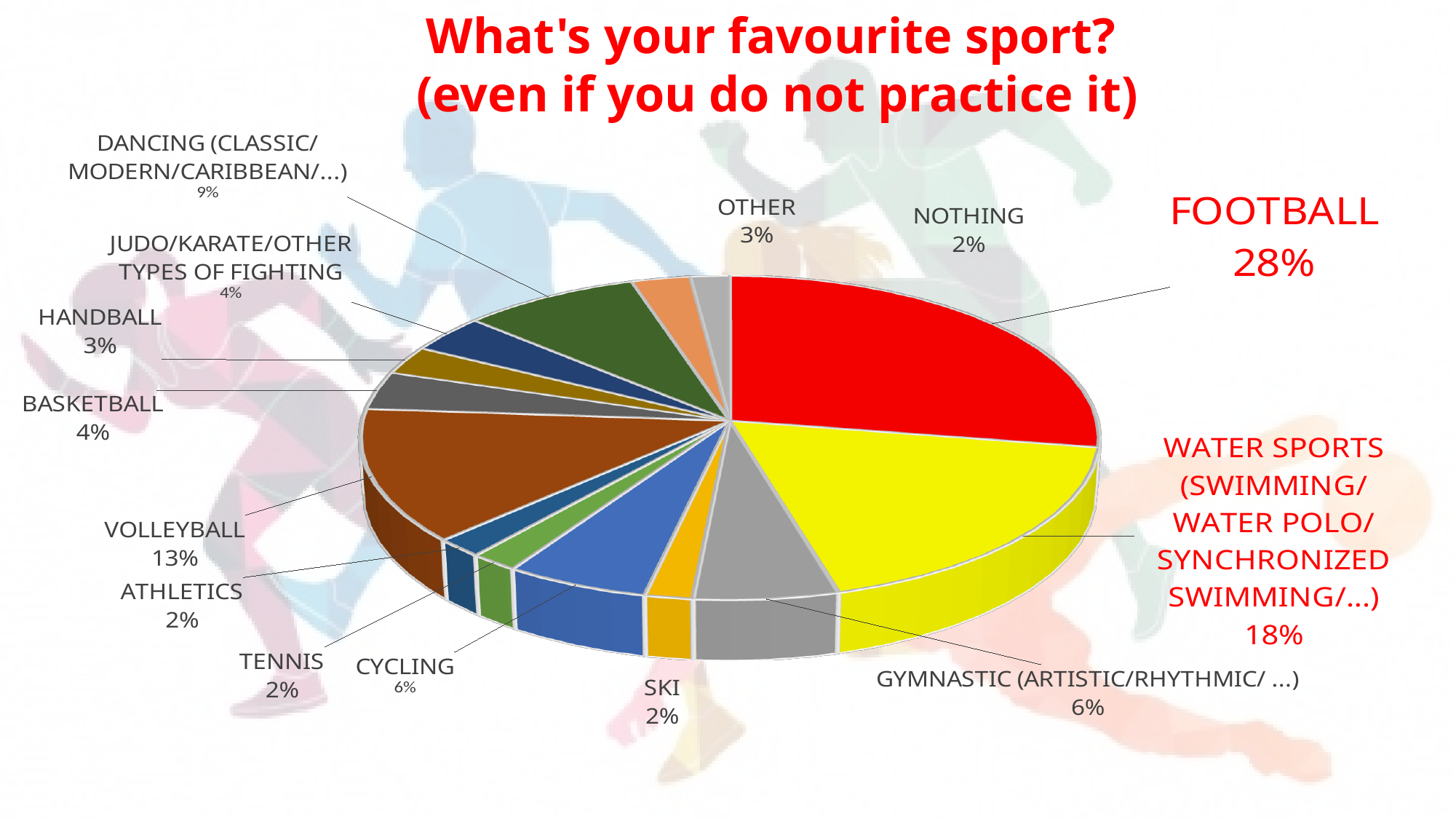
What percentage of respondents chose Football as their favourite sport? 28% Which has a larger share, Volleyball or Dancing? Volleyball Which sport has the largest slice of the pie? Football What percentage of respondents chose Nothing? 2% What is the difference in percentage points between Football and Water Sports? 10 What percentage is shown for Water Sports (swimming/water polo/synchronized swimming/...)? 18% What percentage is shown for Dancing (classic/modern/caribbean/...)? 9% What type of chart is shown on the slide? pie chart Which has a larger share, Cycling or Handball? Cycling What share of the pie does Volleyball represent? 13% How many categories are shown in the pie chart? 14 What is the title of the chart? What's your favourite sport? (even if you do not practice it)